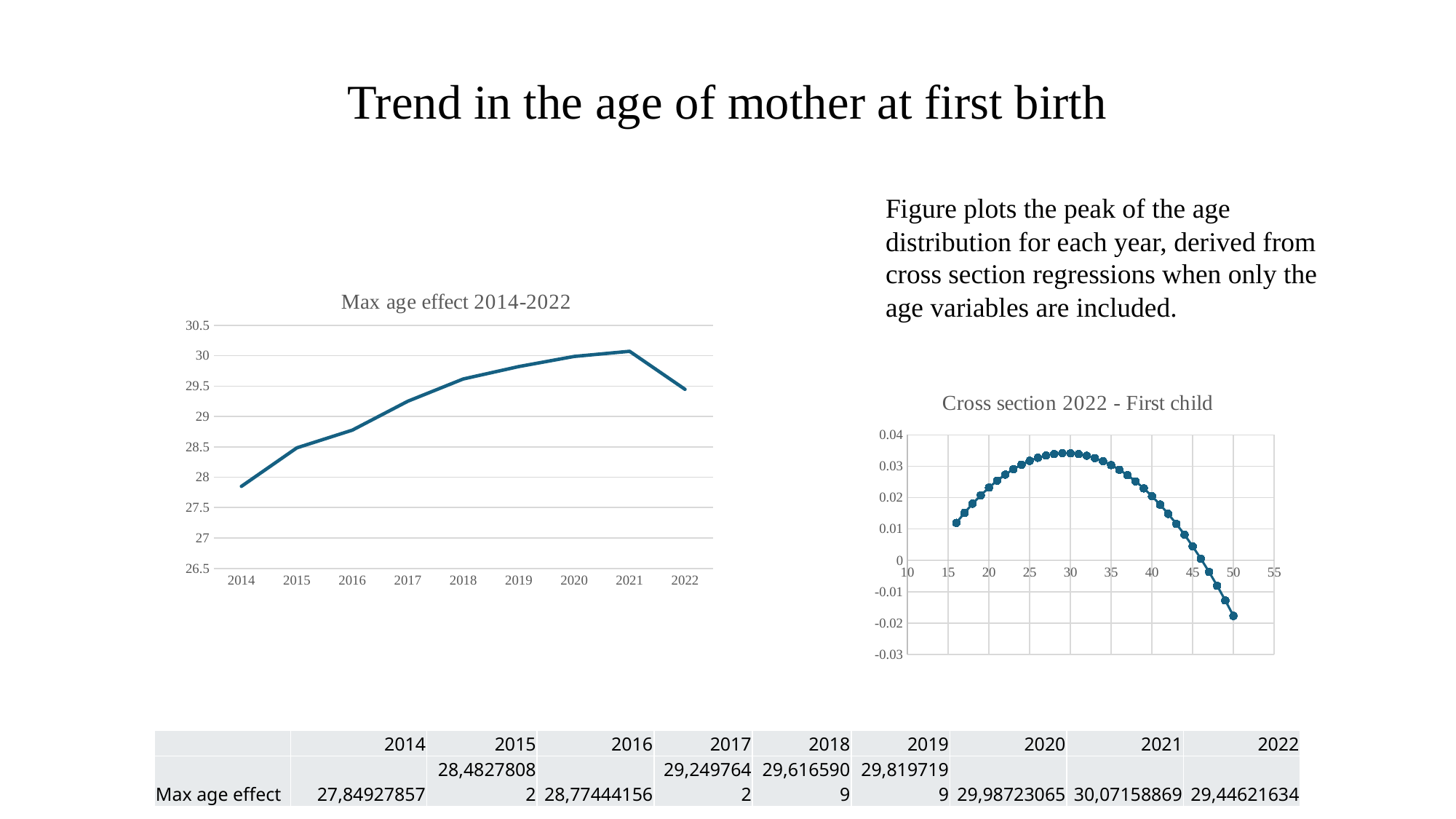
In the 'Cross section 2022 - First child' chart, is the value at age 50 greater or less than 0? less In the 'Max age effect 2014-2022' chart, which year has the lowest value? 2014 In the 'Max age effect 2014-2022' chart, how does the value change from 2014 to 2021? it rises In the 'Max age effect 2014-2022' chart, is the value for 2016 greater or less than 29? less In the 'Cross section 2022 - First child' chart, is the peak value greater or less than 0.03? greater What type of chart is the 'Max age effect 2014-2022' chart? line chart How many years are plotted on the x axis of the 'Max age effect 2014-2022' chart? 9 What is the title of the chart on the right side of the slide? Cross section 2022 - First child In the 'Max age effect 2014-2022' chart, which year has the highest value? 2021 In the 'Max age effect 2014-2022' chart, which year has the larger value, 2014 or 2021? 2021